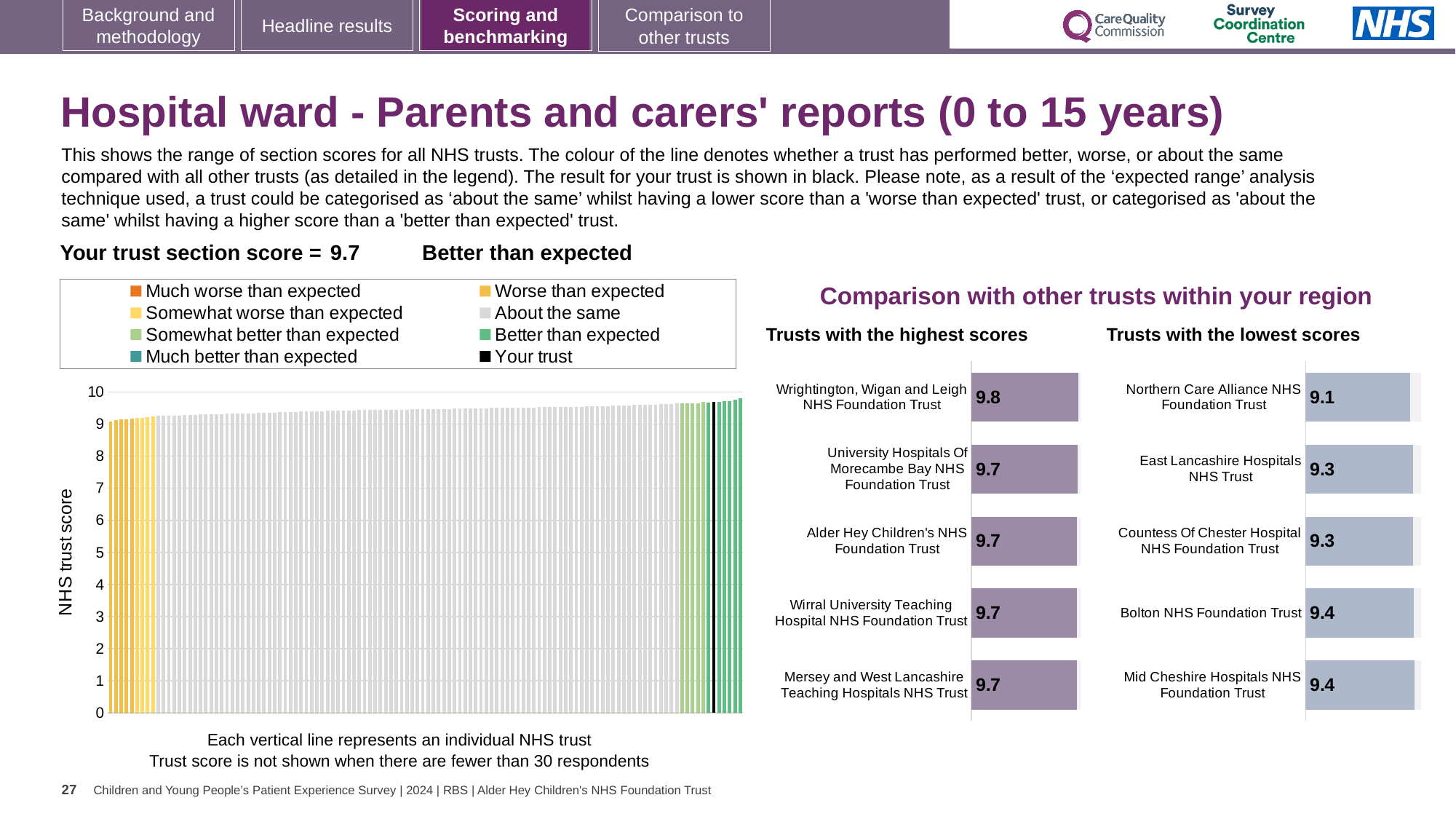
In the 'Trusts with the highest scores' chart, what is the score for Wrightington, Wigan and Leigh NHS Foundation Trust? 9.8 In the 'Trusts with the lowest scores' chart, which trust has the lowest score? Northern Care Alliance NHS Foundation Trust In the 'Trusts with the lowest scores' chart, what is the score for Northern Care Alliance NHS Foundation Trust? 9.1 In the 'Trusts with the lowest scores' chart, what is the score for Bolton NHS Foundation Trust? 9.4 In the 'Trusts with the lowest scores' chart, what is the difference between the score for Mid Cheshire Hospitals NHS Foundation Trust and the score for Northern Care Alliance NHS Foundation Trust? 0.3 How many trusts are shown in the 'Trusts with the highest scores' chart? 5 What kind of chart is the main chart on the left showing the range of section scores? Bar chart In the 'Trusts with the highest scores' chart, which trust has the highest score? Wrightington, Wigan and Leigh NHS Foundation Trust In the 'Trusts with the lowest scores' chart, which has the larger score: East Lancashire Hospitals NHS Trust or Bolton NHS Foundation Trust? Bolton NHS Foundation Trust How many entries does the legend of the main chart on the left list? 8 In the main chart on the left, is the value for 'Your trust' greater or less than 9? greater In the 'Trusts with the highest scores' chart, what is the difference between the score for Wrightington, Wigan and Leigh NHS Foundation Trust and the score for Alder Hey Children's NHS Foundation Trust? 0.1